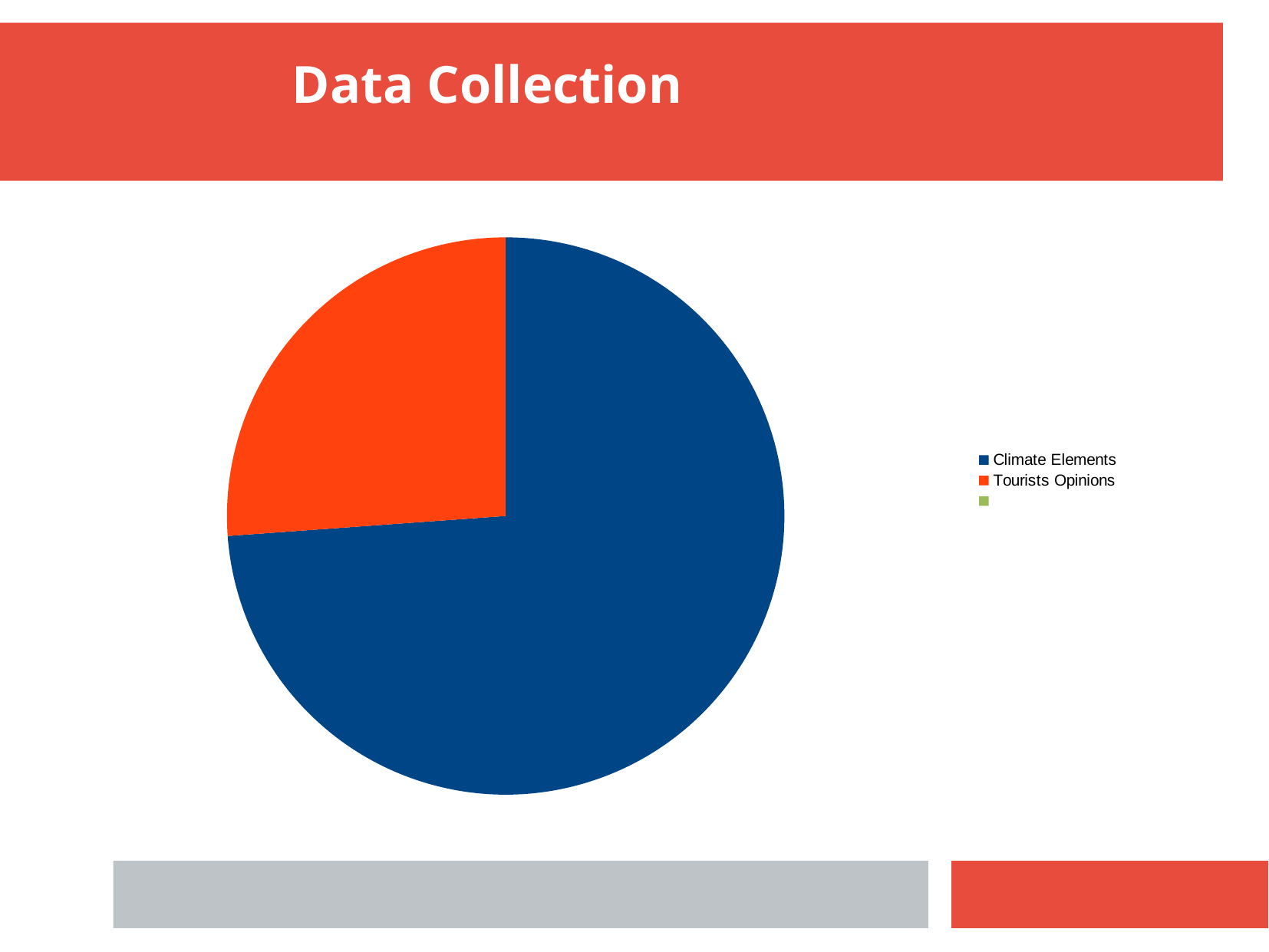
What colour is the Tourists Opinions slice? orange How many labelled entries does the legend list? 2 Which slice is larger, Climate Elements or Tourists Opinions? Climate Elements Which category has the smallest slice of the pie? Tourists Opinions What colour is the Climate Elements slice? blue Which category has the largest slice of the pie? Climate Elements How many slices are visible in the pie chart? 2 What kind of chart is shown on the slide? pie chart